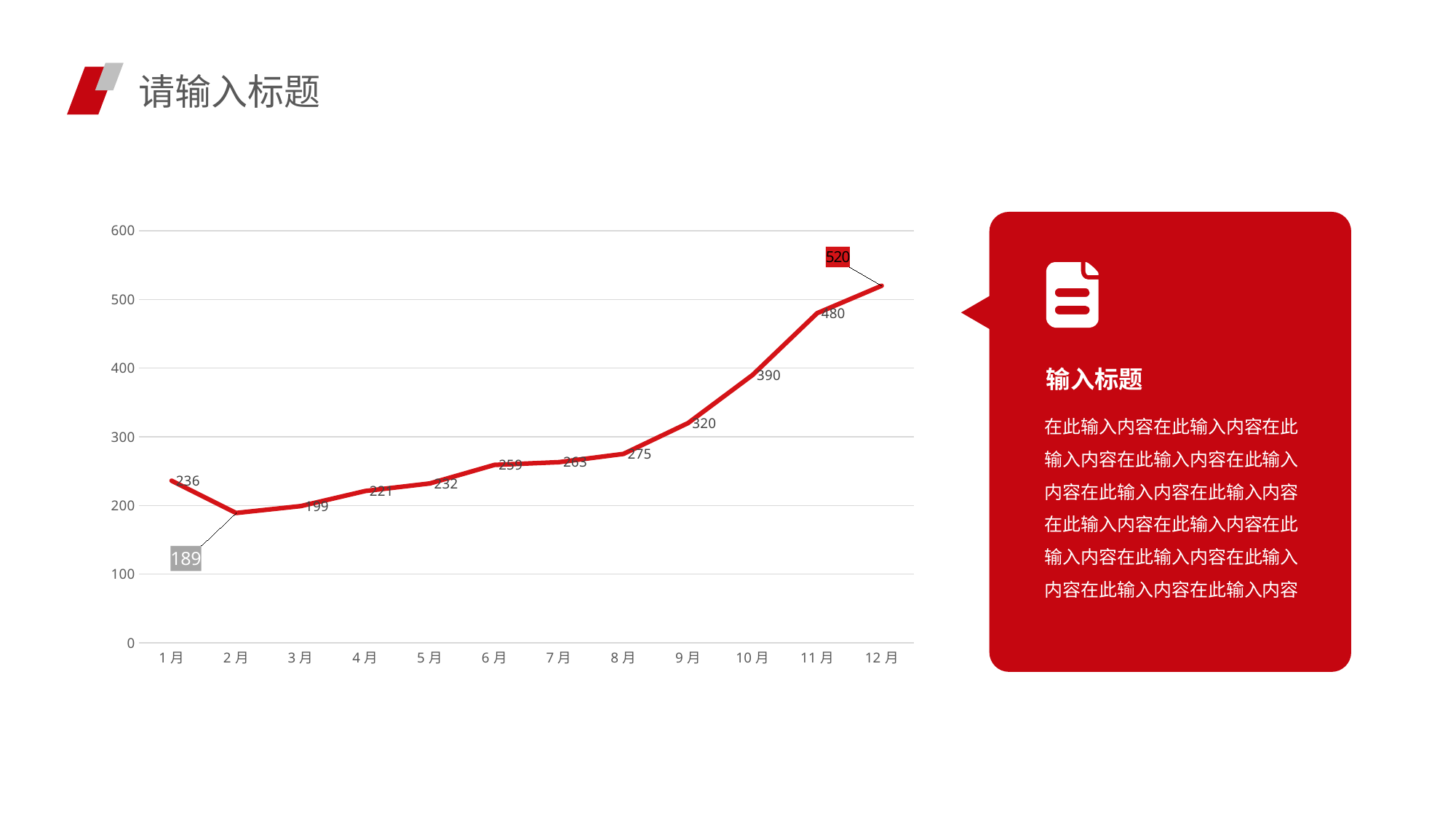
Do the values generally rise or fall from 2月 to 12月? rise What is the difference between the values for 12月 and 11月? 40 What type of chart is shown on the slide? line chart What is the difference between the values for 1月 and 2月? 47 How many months are plotted on the x axis? 12 Which month has the lowest value? 2月 Which is larger, the value for 1月 or the value for 5月? 1月 What is the value for 12月? 520 What is the value for 6月? 259 What is the value for 2月? 189 Which month has the highest value? 12月 What is the value for 9月? 320